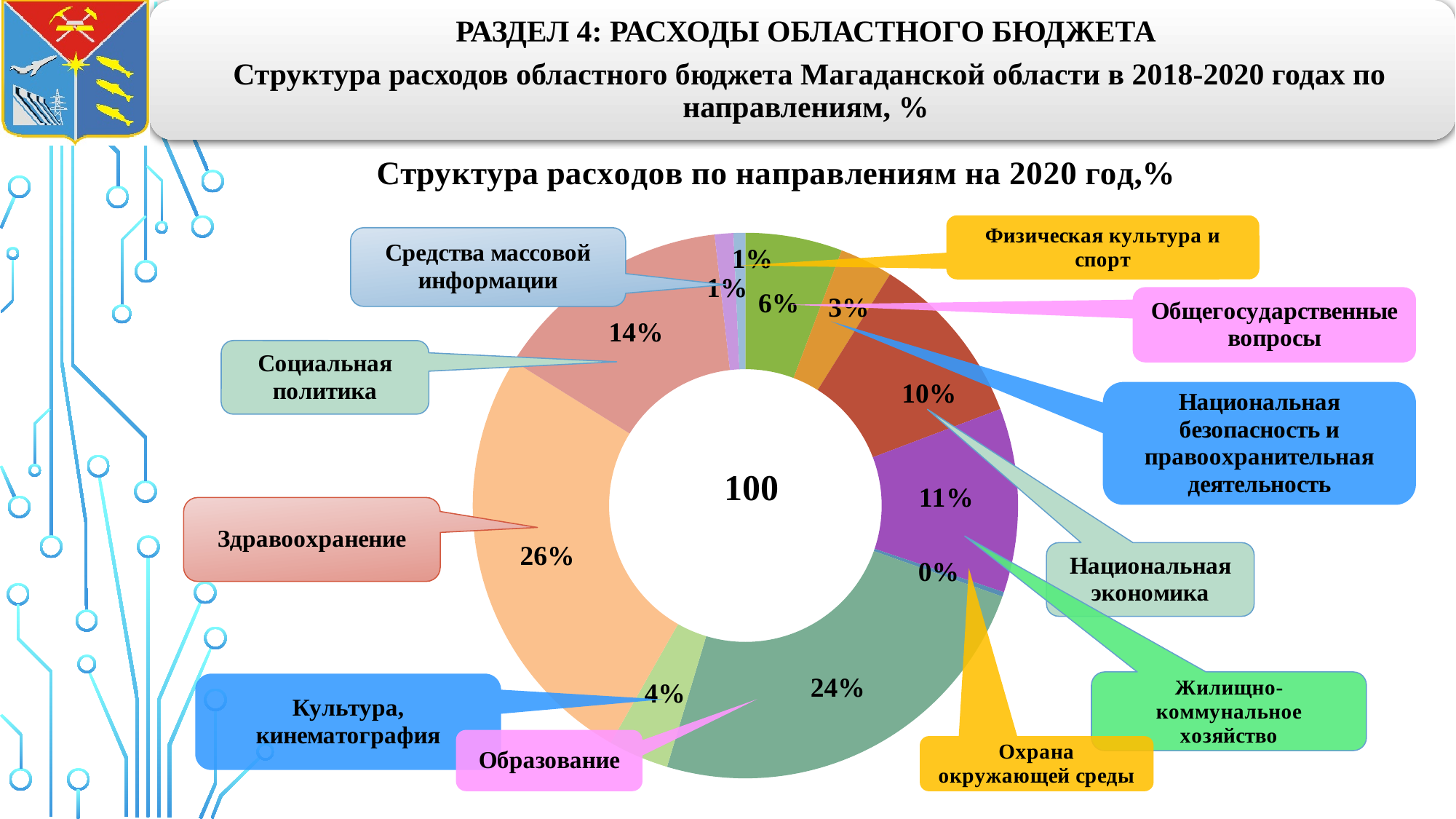
What share of expenditures goes to Культура, кинематография? 4% What is the title of the chart? Структура расходов по направлениям на 2020 год,% Which direction has the largest share of expenditures? Здравоохранение What share of expenditures goes to Национальная экономика? 10% What share of expenditures goes to Образование? 24% What share of expenditures goes to Здравоохранение? 26% What type of chart is shown on the slide? Doughnut (pie) chart Which is larger, the share of Социальная политика or the share of Национальная экономика? Социальная политика What is the difference between the shares of Здравоохранение and Образование? 2% What number is shown in the centre of the doughnut chart? 100 What share of expenditures goes to Социальная политика? 14% How many percentage data labels are shown on the chart? 11